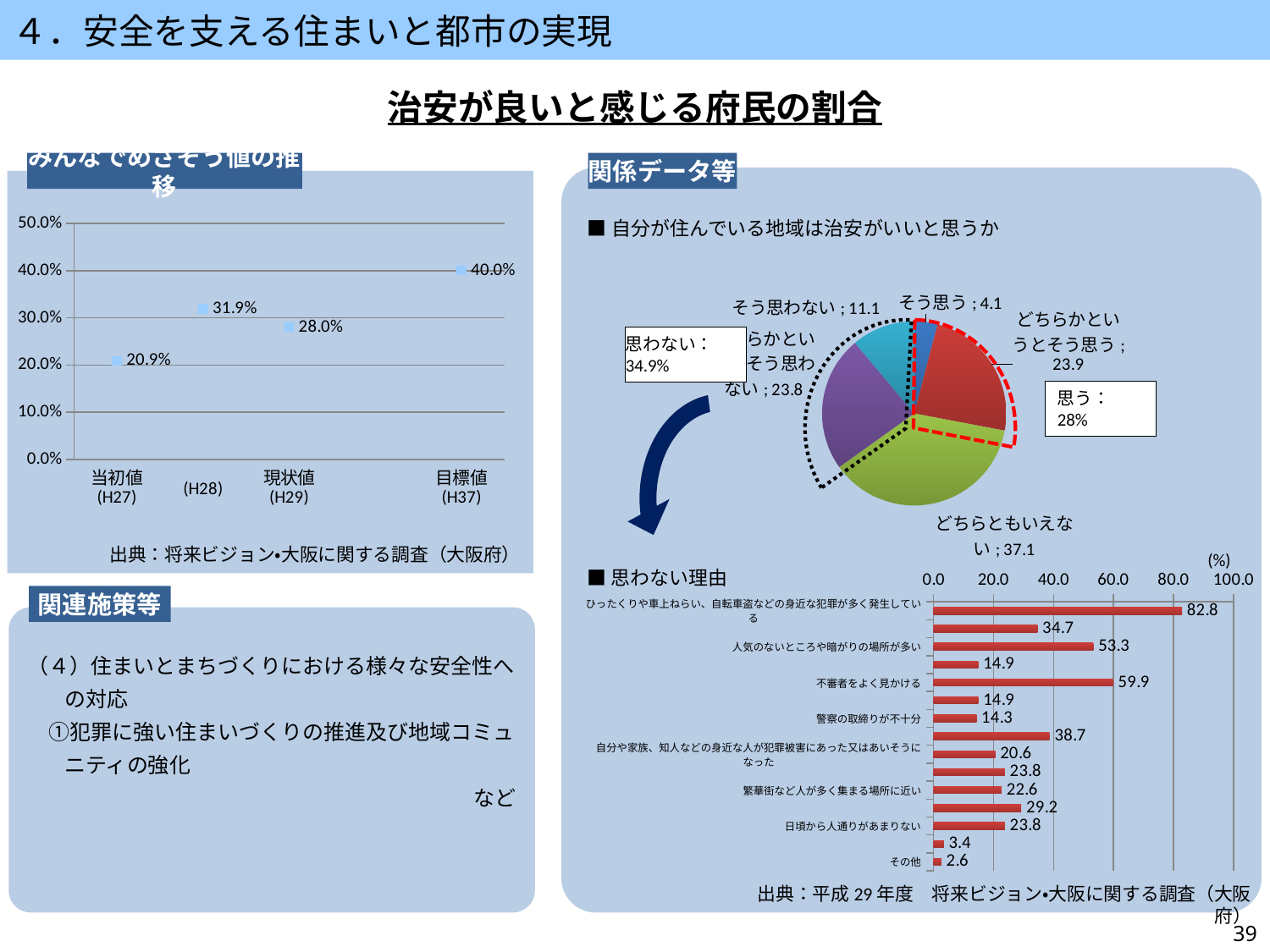
In the left chart titled みんなでめざそう値の推移, what is the value for 当初値 (H27)? 20.9% In the bar chart 思わない理由, what is the value for ひったくりや車上ねらい、自転車盗などの身近な犯罪が多く発生している? 82.8 In the pie chart 自分が住んでいる地域は治安がいいと思うか, what is the value for どちらともいえない? 37.1 In the pie chart 自分が住んでいる地域は治安がいいと思うか, which category has the smallest slice? そう思う In the pie chart 自分が住んでいる地域は治安がいいと思うか, how many slices are there? 5 In the left chart titled みんなでめざそう値の推移, what is the difference between the 現状値 (H29) and the 当初値 (H27)? 7.1% In the left chart titled みんなでめざそう値の推移, how many data points are plotted? 4 In the bar chart 思わない理由, what is the value for 不審者をよく見かける? 59.9 In the bar chart 思わない理由, which category has the lowest value? その他 In the left chart titled みんなでめざそう値の推移, which is larger, the value for H28 or the value for 現状値 (H29)? H28 What kind of chart is the 思わない理由 chart? bar chart In the left chart titled みんなでめざそう値の推移, what is the value for 目標値 (H37)? 40.0%